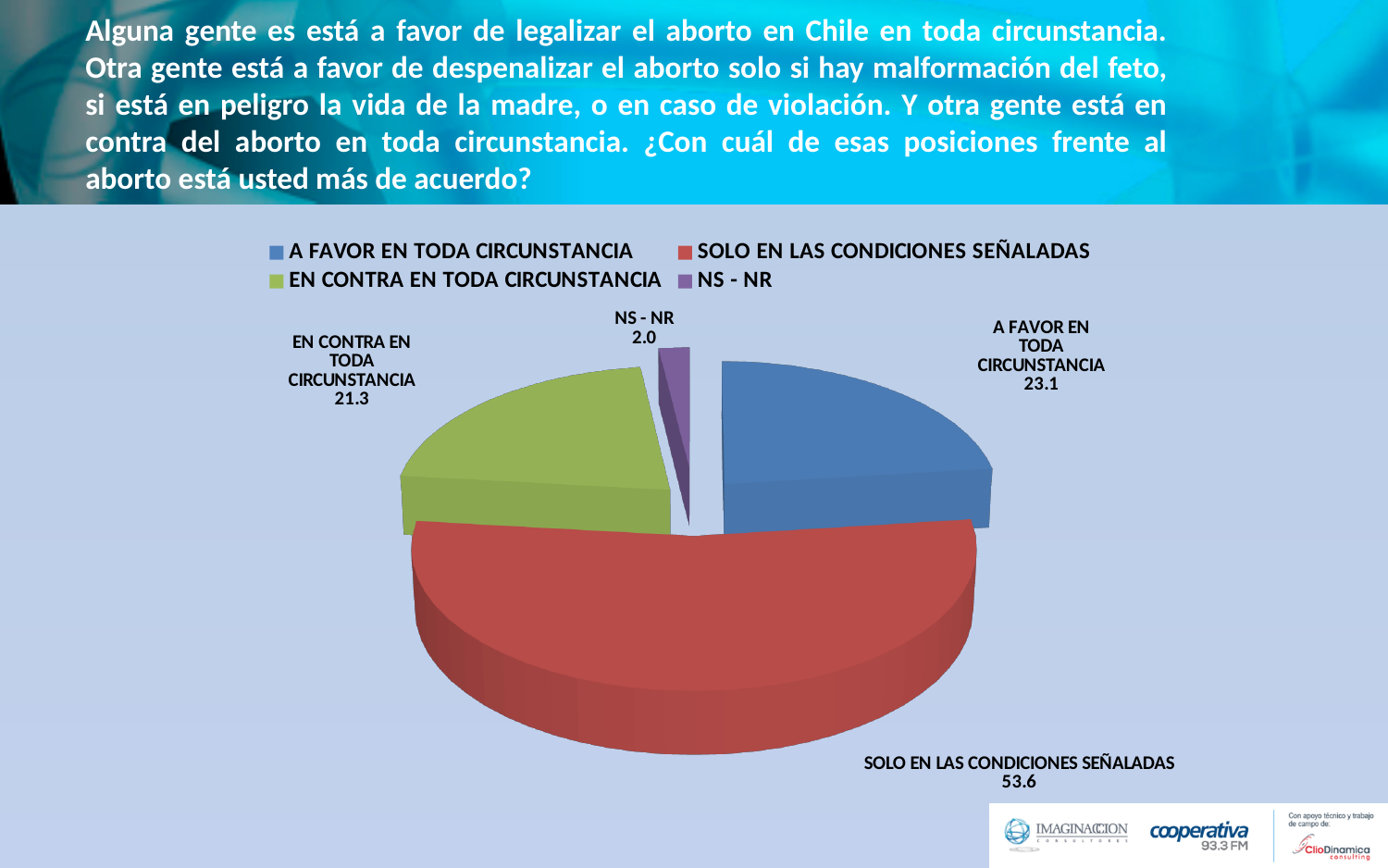
What is the value for A FAVOR EN TODA CIRCUNSTANCIA? 23.1 What is the difference between the values for A FAVOR EN TODA CIRCUNSTANCIA and EN CONTRA EN TODA CIRCUNSTANCIA? 1.8 Which category has the largest slice of the pie? SOLO EN LAS CONDICIONES SEÑALADAS What is the value for NS - NR? 2.0 What kind of chart is shown on the slide? Pie chart How many slices does the pie chart have? 4 What is the difference between the values for SOLO EN LAS CONDICIONES SEÑALADAS and A FAVOR EN TODA CIRCUNSTANCIA? 30.5 What colour is the slice for SOLO EN LAS CONDICIONES SEÑALADAS? Red What is the value for EN CONTRA EN TODA CIRCUNSTANCIA? 21.3 What is the value for SOLO EN LAS CONDICIONES SEÑALADAS? 53.6 Which is larger, the value for A FAVOR EN TODA CIRCUNSTANCIA or the value for NS - NR? A FAVOR EN TODA CIRCUNSTANCIA Which category has the smallest slice of the pie? NS - NR